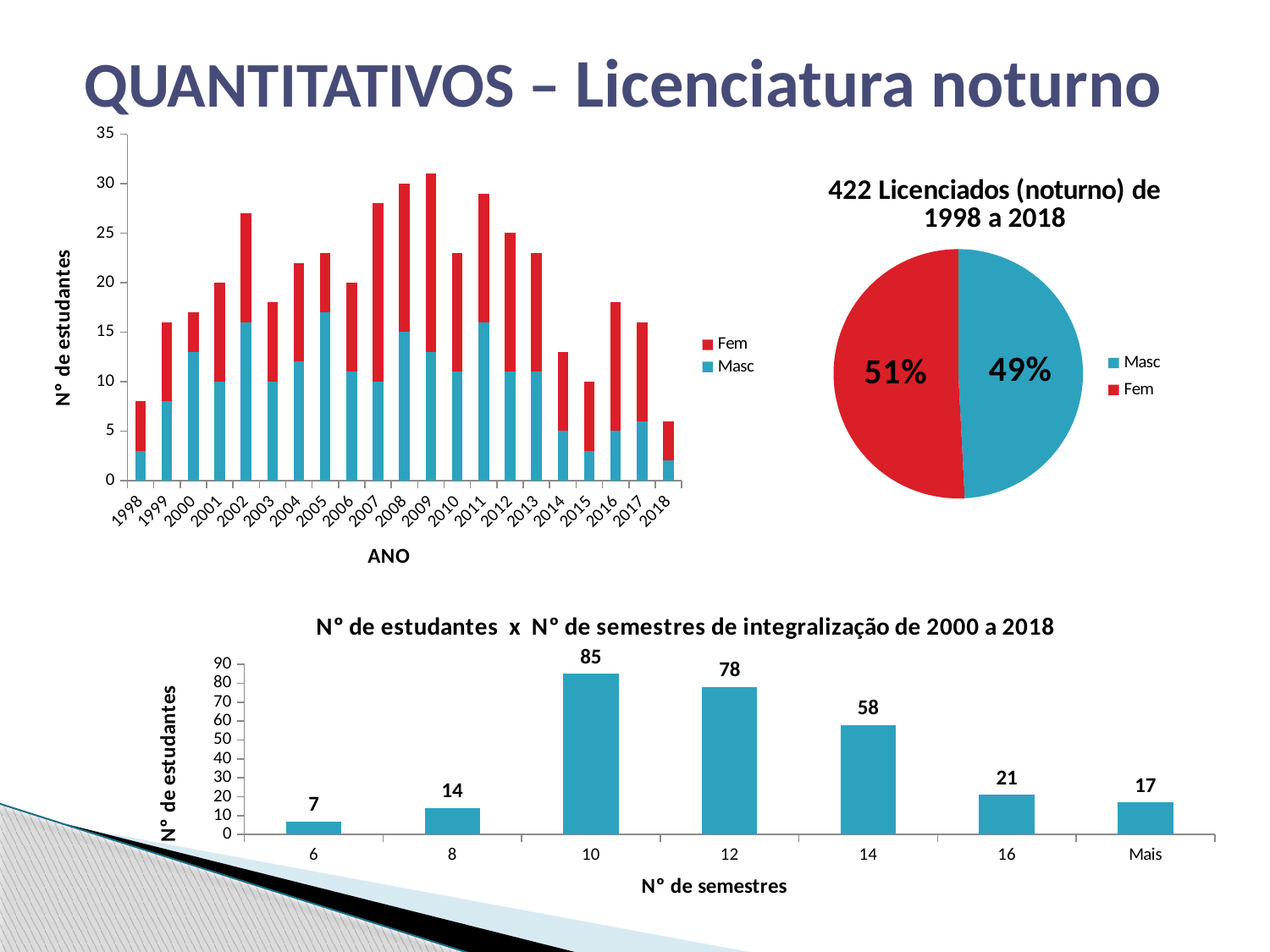
In the bottom chart 'N° de estudantes x N° de semestres de integralização de 2000 a 2018', which number of semesters has the highest number of students? 10 In the bottom chart 'N° de estudantes x N° de semestres de integralização de 2000 a 2018', which is larger, the value for 16 semesters or for 'Mais'? 16 semesters In the bottom chart 'N° de estudantes x N° de semestres de integralização de 2000 a 2018', how many categories are shown on the x axis? 7 In the bottom chart 'N° de estudantes x N° de semestres de integralização de 2000 a 2018', what is the value for 10 semesters? 85 In the pie chart '422 Licenciados (noturno) de 1998 a 2018', what share is Fem? 51% In the pie chart '422 Licenciados (noturno) de 1998 a 2018', which slice is larger, Masc or Fem? Fem In the bottom chart 'N° de estudantes x N° de semestres de integralização de 2000 a 2018', which number of semesters has the lowest number of students? 6 In the top-left stacked bar chart with x axis 'ANO', how many years are shown on the x axis? 21 In the top-left stacked bar chart with x axis 'ANO', is the total value for 2009 greater or less than 30? greater In the bottom chart 'N° de estudantes x N° de semestres de integralização de 2000 a 2018', what is the difference between the values for 12 and 14 semesters? 20 In the top-left stacked bar chart with x axis 'ANO', how many series does the legend list? 2 In the bottom chart 'N° de estudantes x N° de semestres de integralização de 2000 a 2018', what is the value for the 'Mais' category? 17